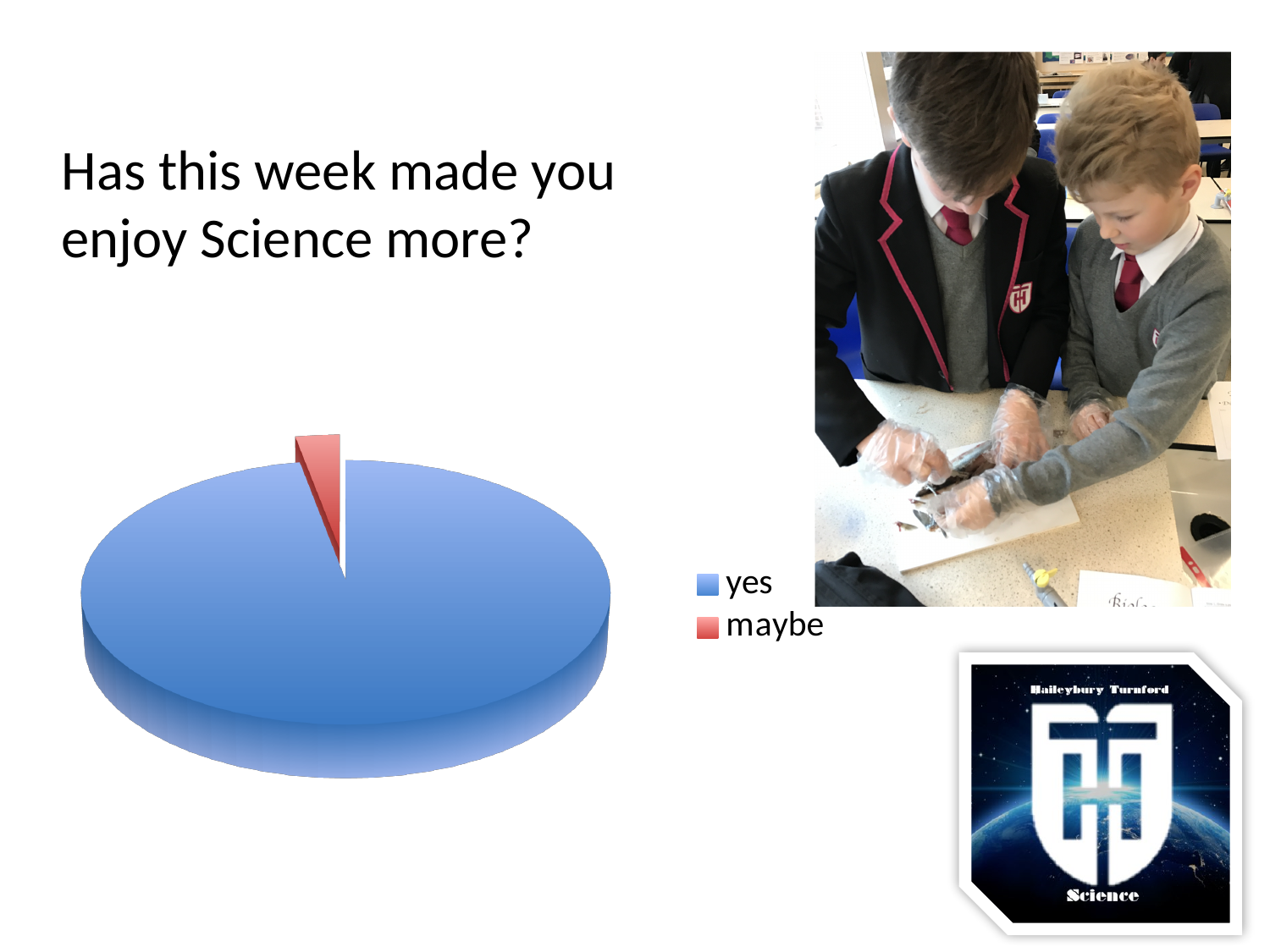
What are the two categories listed in the pie chart's legend? yes, maybe Which category has the smallest slice in the pie chart? maybe How many entries does the legend of the pie chart list? 2 How many slices does the pie chart have? 2 Which category has the largest slice in the pie chart? yes Which slice is larger in the pie chart, yes or maybe? yes What kind of chart is shown on the slide? pie chart Does the 'maybe' slice take up more or less than half of the pie chart? less What colour is the 'yes' slice in the pie chart? blue